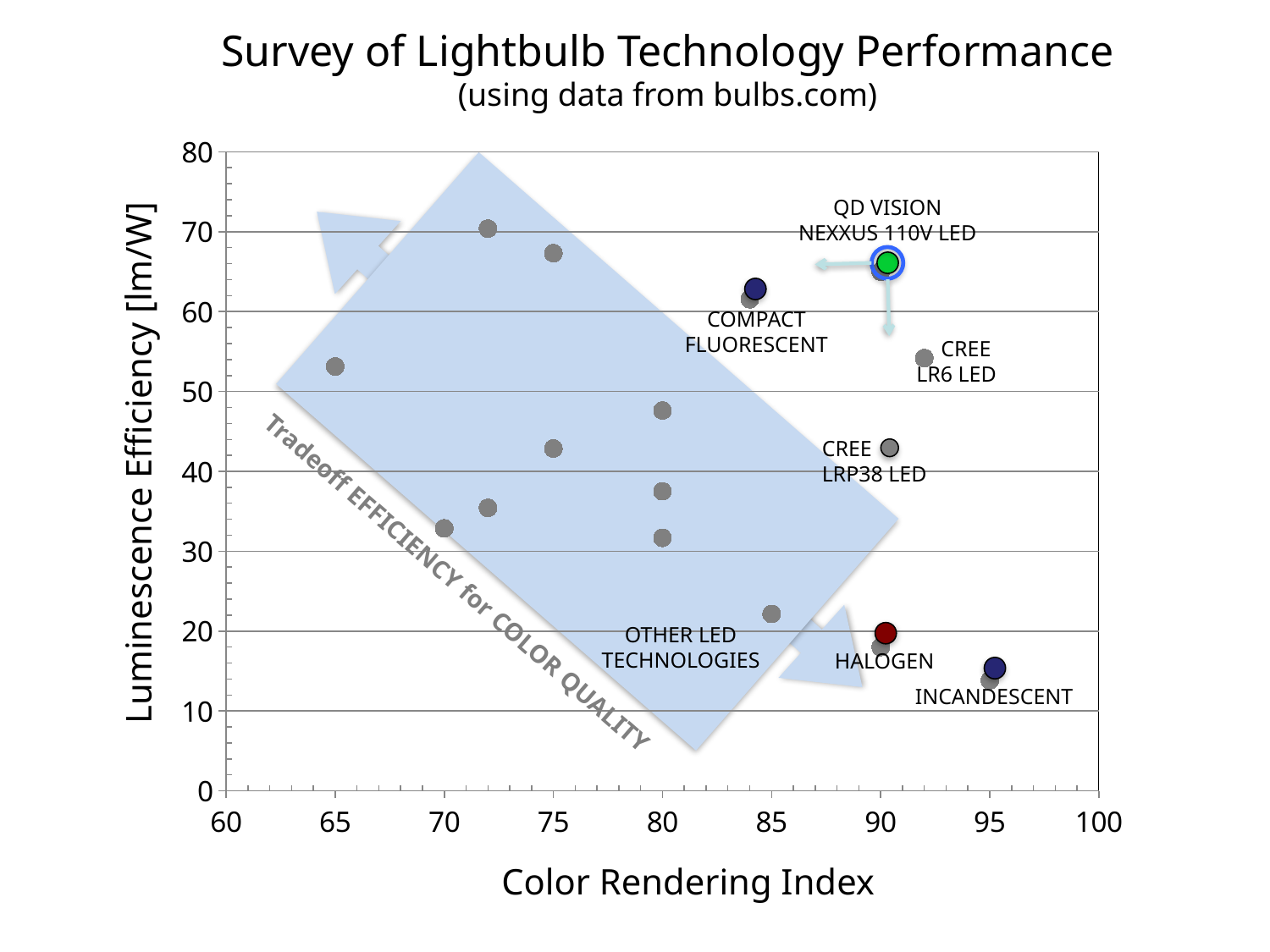
Is the luminescence efficiency of the Halogen bulb greater or less than 30? less Which has the higher Color Rendering Index, the Incandescent bulb or the Compact Fluorescent bulb? Incandescent Do the luminescence efficiency values generally rise or fall as the Color Rendering Index increases? fall Is the luminescence efficiency of the QD Vision Nexxus 110V LED greater or less than 60? greater What kind of chart is shown on the slide? scatter chart Among the labelled bulb technologies, which has the lowest luminescence efficiency? Incandescent Which has the higher luminescence efficiency, the QD Vision Nexxus 110V LED or the Halogen bulb? QD Vision Nexxus 110V LED Is the Color Rendering Index of the Incandescent bulb greater or less than 90? greater What is the title of the chart? Survey of Lightbulb Technology Performance What is the label of the x axis? Color Rendering Index